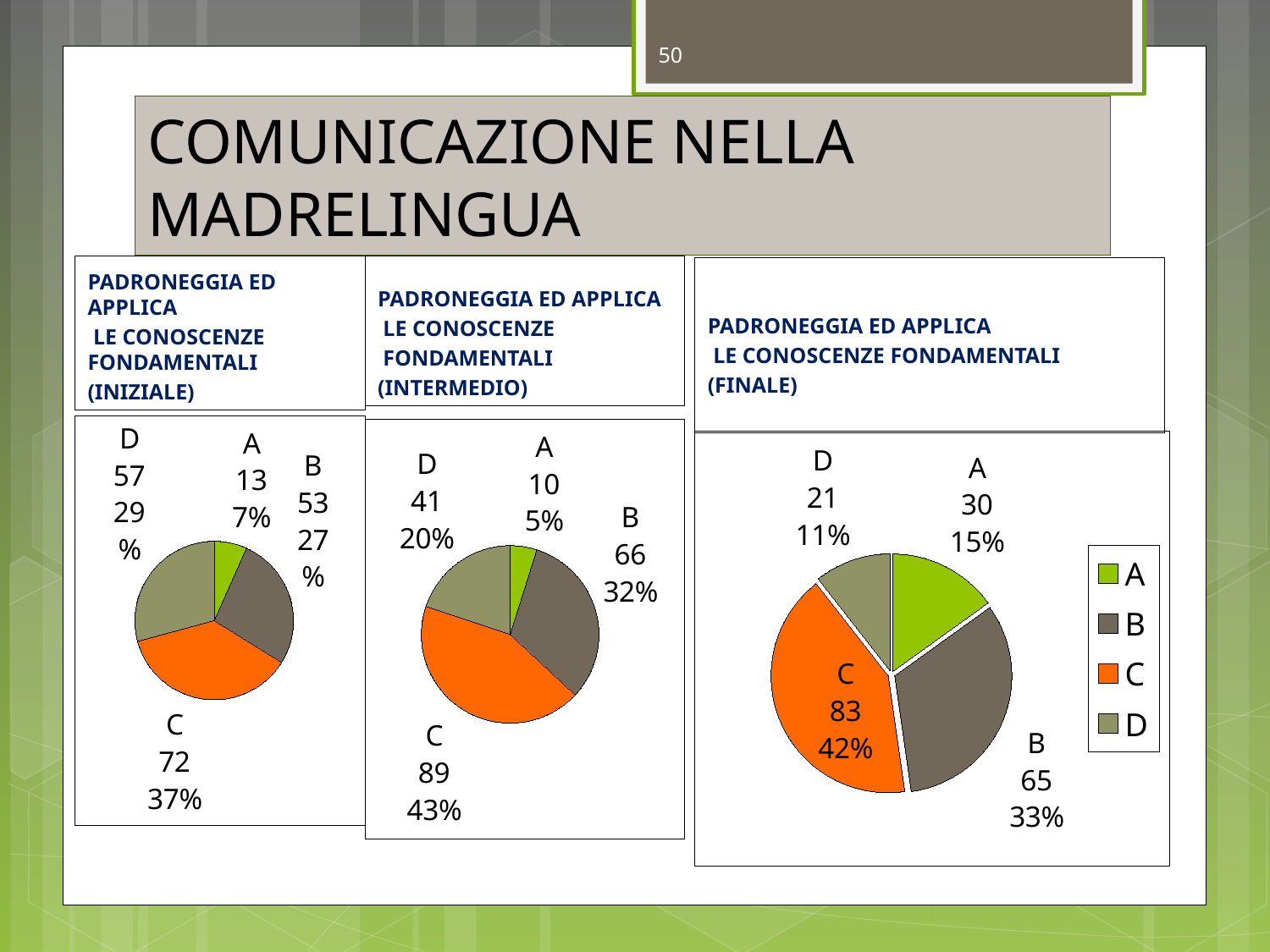
In the INIZIALE pie chart, what percentage share does category D have? 29% In the INIZIALE pie chart, what is the value for category C? 72 How many categories does the INIZIALE pie chart show? 4 In the FINALE pie chart, what is the value for category A? 30 What type of chart is used for the FINALE data? Pie chart How many entries does the legend next to the FINALE chart list? 4 In the INTERMEDIO pie chart, what is the value for category B? 66 In the INTERMEDIO pie chart, which category has the smallest slice? A In the FINALE pie chart, which category has the largest slice? C In the FINALE pie chart, what is the difference between the values for C and B? 18 In the FINALE pie chart, what percentage share does category B have? 33% In the INTERMEDIO pie chart, which is larger, the value for D or the value for A? D